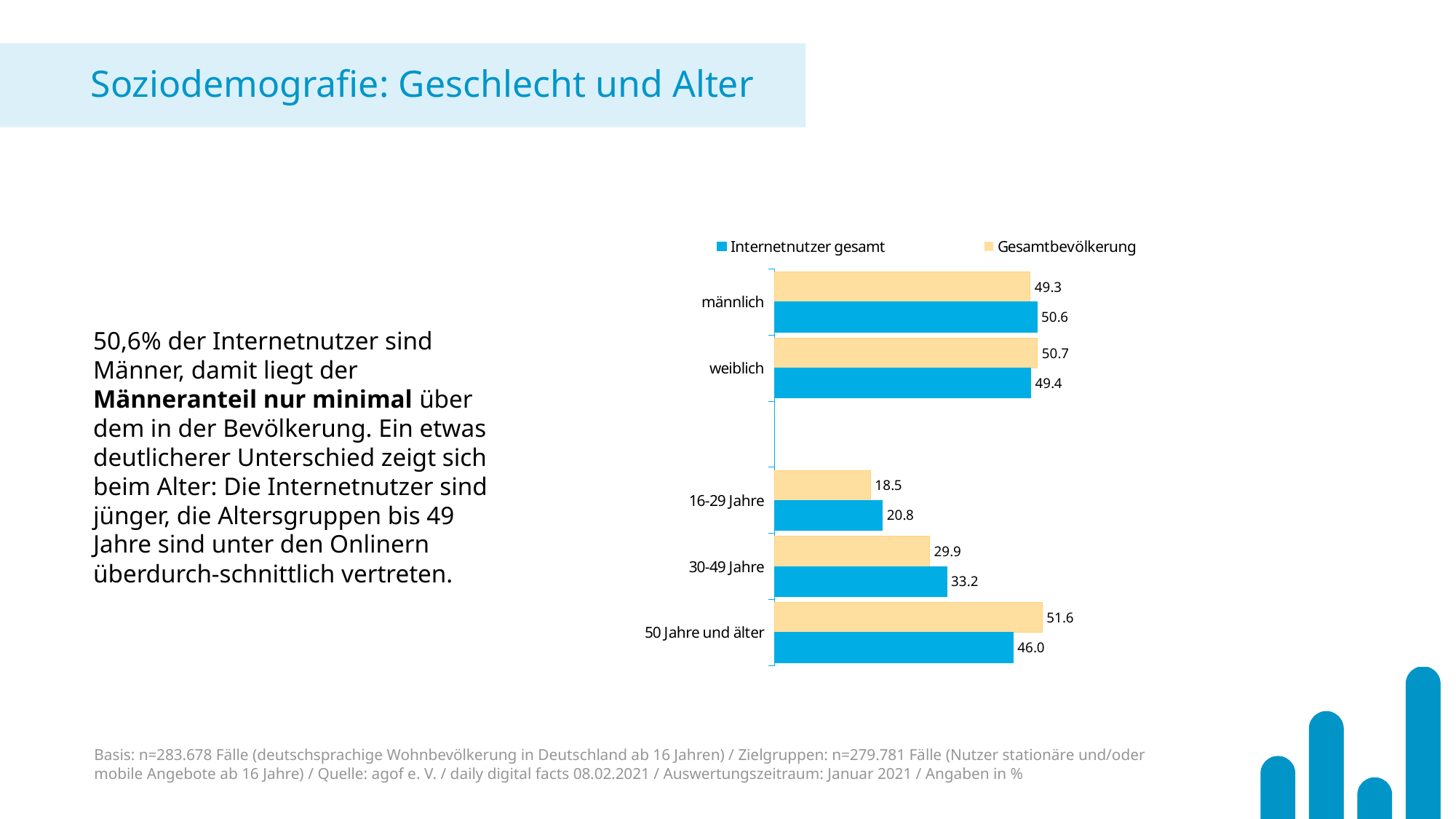
How many series does the legend list? 2 Which category has the lowest value for Gesamtbevölkerung? 16-29 Jahre Which is larger in the 30-49 Jahre category: Internetnutzer gesamt or Gesamtbevölkerung? Internetnutzer gesamt What kind of chart is shown on the slide? Bar chart What is the value for Internetnutzer gesamt in the 16-29 Jahre category? 20.8 What is the value for Internetnutzer gesamt in the männlich category? 50.6 What is the value for Gesamtbevölkerung in the 50 Jahre und älter category? 51.6 What is the value for Gesamtbevölkerung in the 30-49 Jahre category? 29.9 How many categories are shown on the chart? 5 What is the difference between Gesamtbevölkerung and Internetnutzer gesamt in the 50 Jahre und älter category? 5.6 Which category has the highest value for Internetnutzer gesamt? männlich Which colour represents the Gesamtbevölkerung series? Light yellow